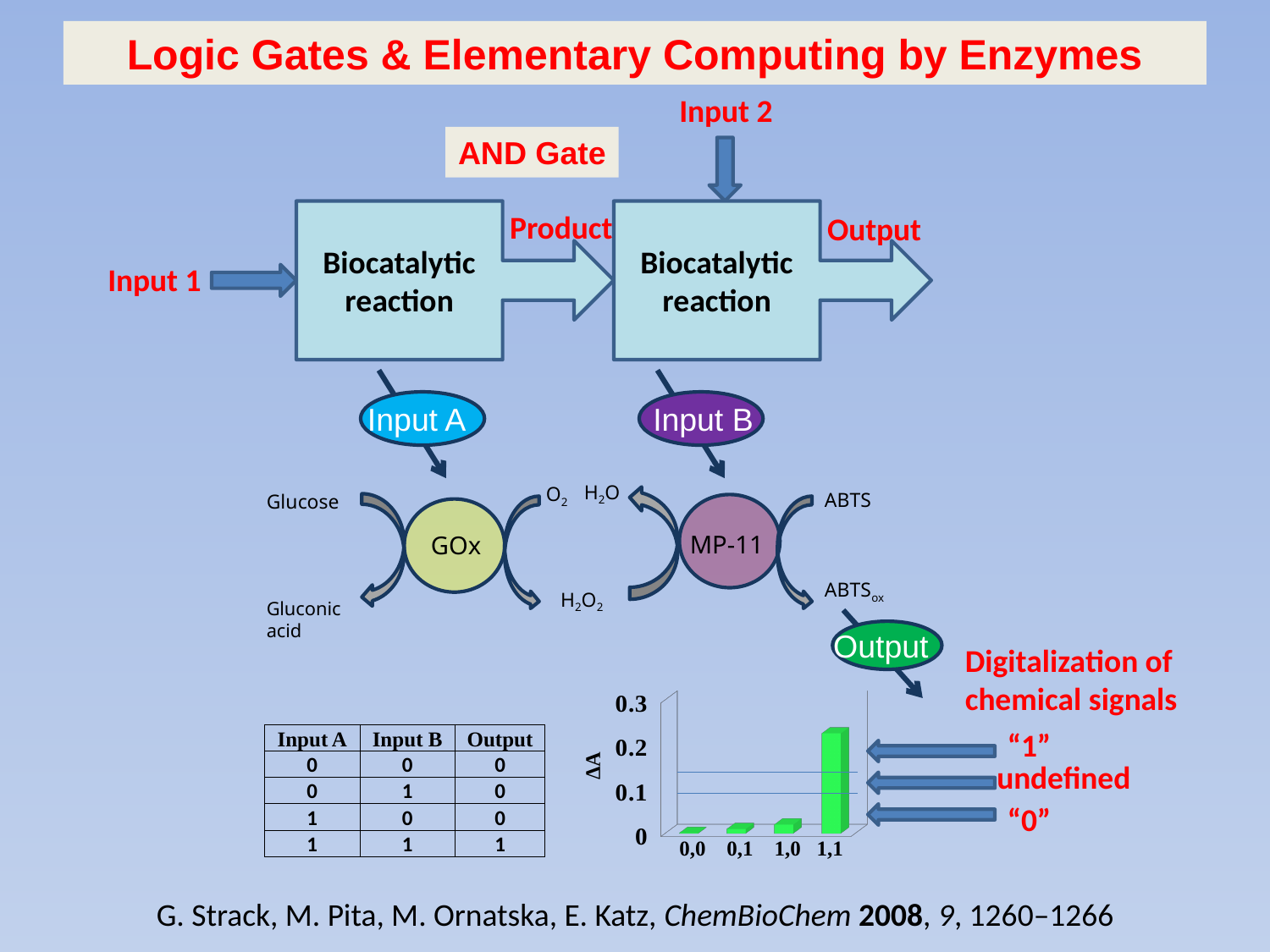
What is the label of the vertical axis of the bar chart? ΔA Is the value for 1,1 in the bar chart greater or less than 0.2? greater In the bar chart, which is larger, the value for 1,1 or the value for 1,0? 1,1 How many categories are plotted on the x axis of the bar chart? 4 Which category has the highest bar in the bar chart? 1,1 Is the value for 0,0 in the bar chart greater or less than 0.1? less Which category in the bar chart is the only one whose bar rises above 0.2? 1,1 What is the highest tick value shown on the vertical axis of the bar chart? 0.3 What kind of chart is shown at the bottom right of the slide? bar chart